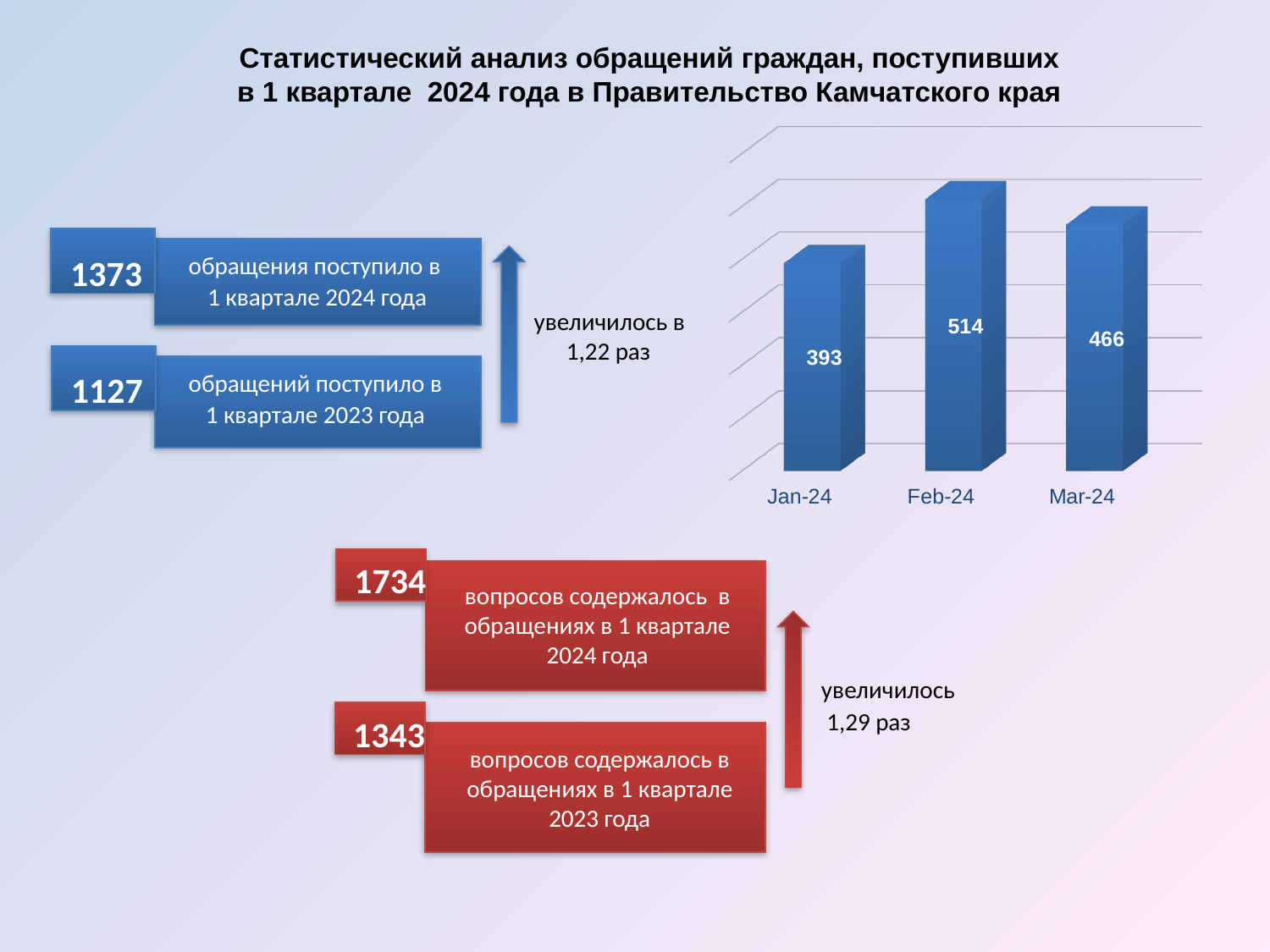
How many months are shown in the bar chart? 3 Which month has the lowest value in the bar chart? Jan-24 What is the value for Feb-24 in the bar chart? 514 What is the difference between the values for Feb-24 and Mar-24 in the bar chart? 48 What is the total of the three monthly values in the bar chart? 1373 What is the value for Jan-24 in the bar chart? 393 What is the value for Mar-24 in the bar chart? 466 What kind of chart is shown on the slide? bar chart Which month has the highest value in the bar chart? Feb-24 What is the difference between the values for Feb-24 and Jan-24 in the bar chart? 121 Does the value rise or fall from Jan-24 to Feb-24 in the bar chart? rise Which is larger in the bar chart, the value for Mar-24 or the value for Jan-24? Mar-24